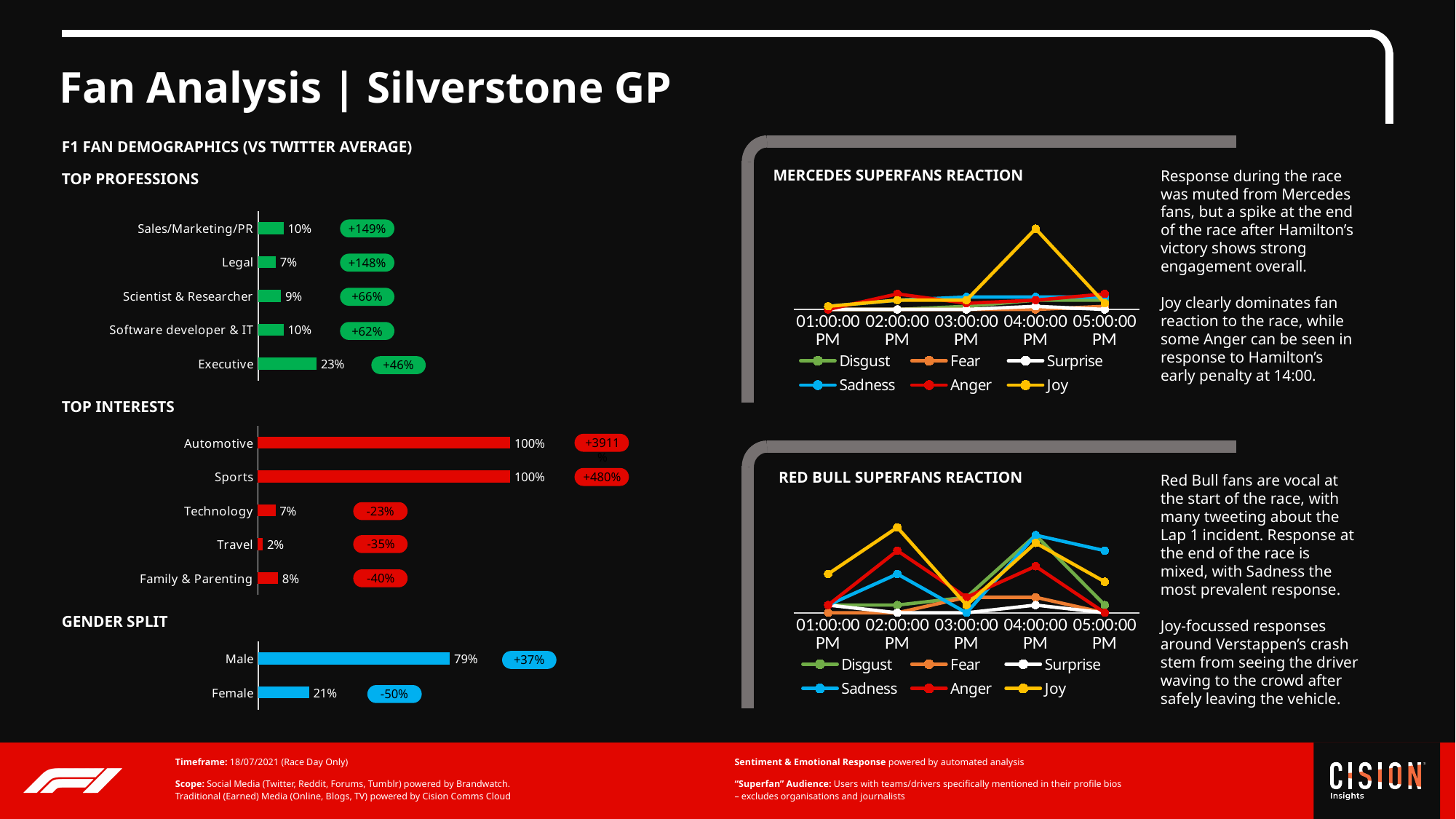
In the Top Interests chart, what is the value for Travel? 2% In the Top Interests chart, how many interest categories are shown? 5 In the Gender Split chart, which is larger, Male or Female? Male In the Top Professions chart, what is the value for Executive? 23% In the Mercedes Superfans Reaction chart, how many series does the legend list? 6 In the Top Professions chart, which profession has the highest value? Executive In the Top Professions chart, which profession has the lowest value? Legal In the Top Professions chart, what is the difference between the values for Executive and Legal? 16% What kind of chart is the Red Bull Superfans Reaction chart? Line chart In the Mercedes Superfans Reaction chart, at which time does Joy reach its highest point? 04:00:00 PM In the Top Interests chart, which interest has the lowest value? Travel In the Gender Split chart, what is the difference between the Male and Female values? 58%